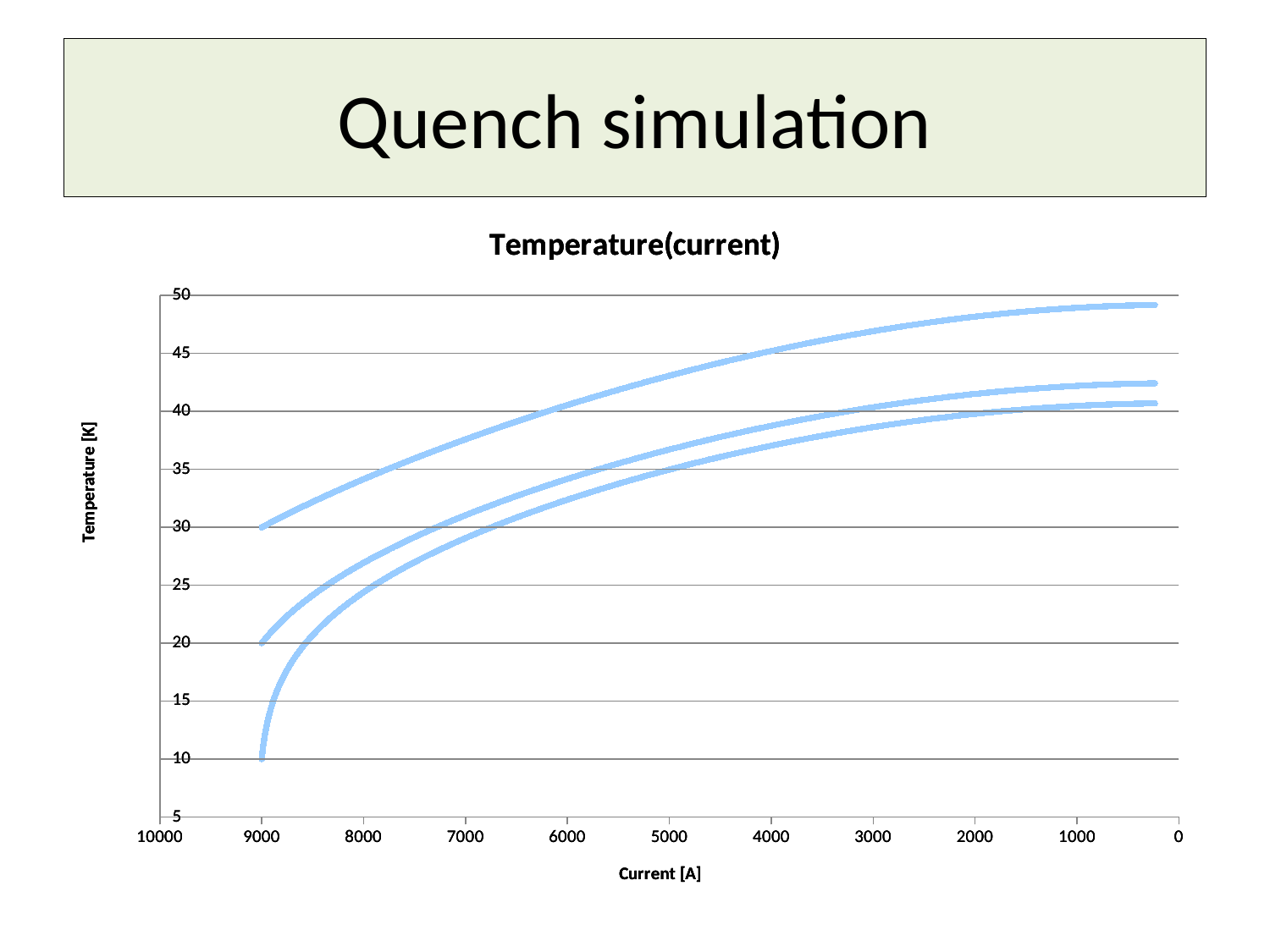
Is the temperature of the lowest curve at 6000 A greater or less than 30? greater How many curves are plotted on the chart? 3 What kind of chart is shown on the slide? Line chart At what temperature does the lowest curve start at 9000 A? 10 Is the temperature of the lowest curve at 3000 A greater or less than 40? less Is the temperature of the top curve at 1000 A greater or less than 45? greater At what temperature does the top curve start at 9000 A? 30 Do the curves rise or fall moving from left to right along the x axis (from 10000 A toward 0 A)? Rise What is the title of the chart? Temperature(current) At what temperature does the middle curve start at 9000 A? 20 What are the x-axis and y-axis labels of the chart? Current [A] and Temperature [K] Which curve reaches the highest temperature at low current: the one starting at 10 K, 20 K or 30 K? The one starting at 30 K